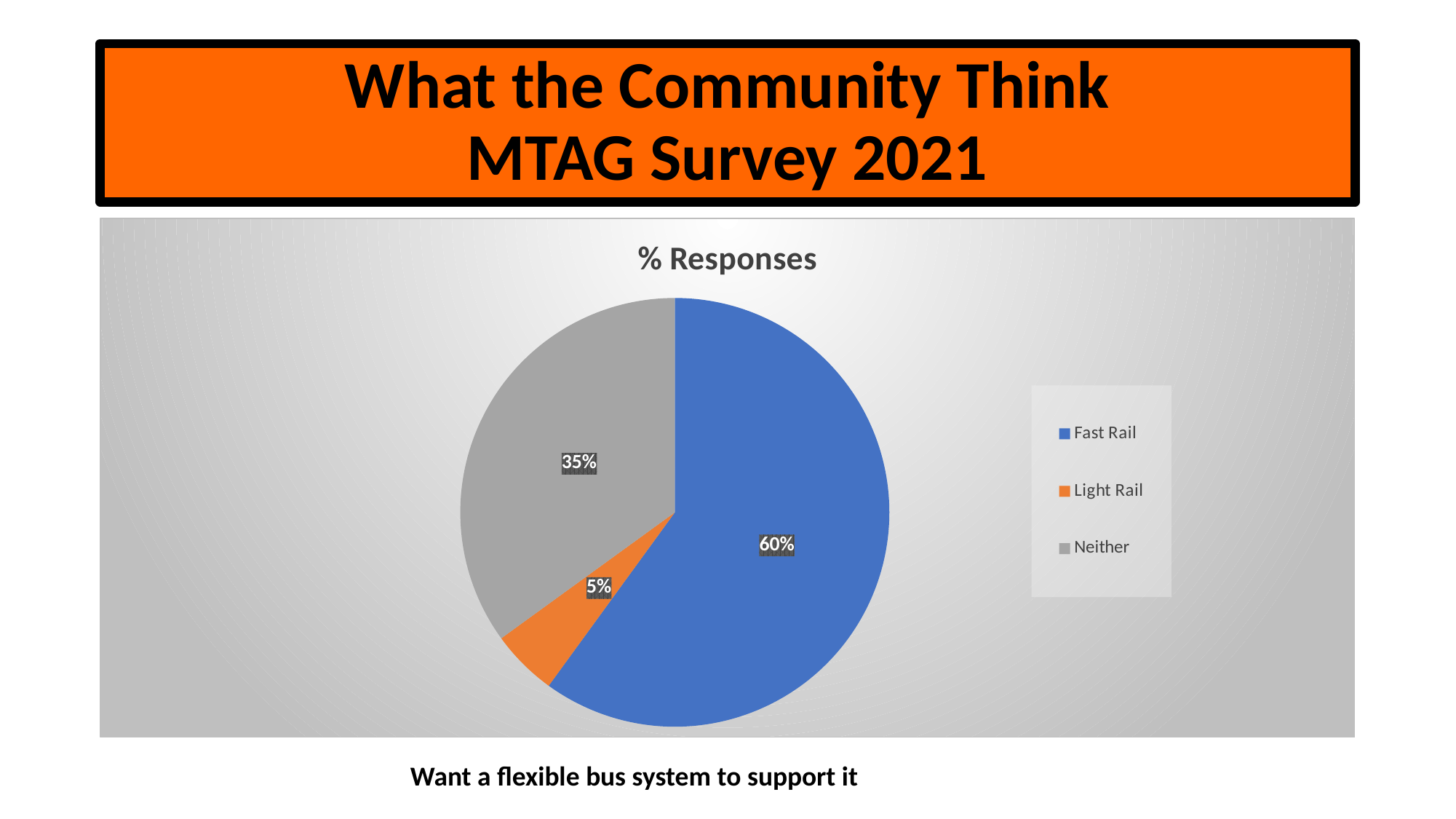
Which category has the smallest share of responses? Light Rail What is the difference in percentage points between Fast Rail and Neither? 25 What percentage of responses is shown for Neither? 35% How many categories does the pie chart show? 3 Which has a larger share of responses, Neither or Light Rail? Neither What kind of chart is shown on the slide? Pie chart Which category has the largest share of responses? Fast Rail What percentage of responses is shown for Light Rail? 5% What is the title of the chart? % Responses What is the difference in percentage points between Neither and Light Rail? 30 Which colour represents Light Rail in the chart? Orange What percentage of responses is shown for Fast Rail? 60%